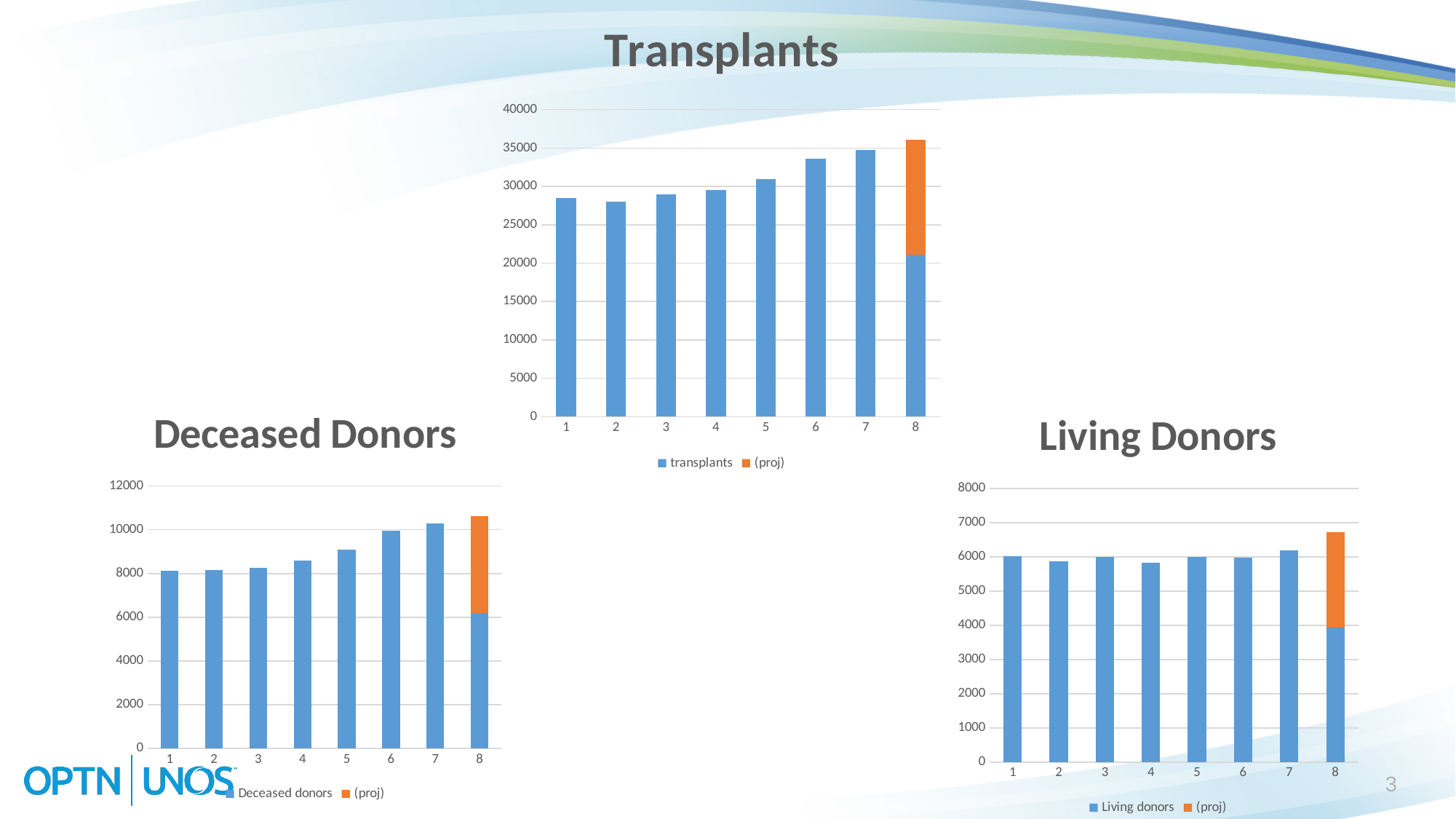
In the Living Donors chart, which category has the tallest bar overall (including the projected portion)? 8 In the Deceased Donors chart, do the values generally rise or fall from category 1 to category 7? rise How many categories are shown on the x axis of the Deceased Donors chart? 8 In the Living Donors chart, is the total height of the stacked bar for category 8 greater or less than 6000? greater In the Transplants chart, which category has the tallest blue (transplants) bar? 7 What colour is the (proj) series in the Transplants chart? orange In the Transplants chart, is the value for category 1 greater or less than 30000? less In the Transplants chart, which is larger, the value for category 4 or category 6? category 6 In the Deceased Donors chart, is the value for category 5 greater or less than 8000? greater How many series does the legend of the Living Donors chart list? 2 What kind of chart is the Transplants chart? bar chart